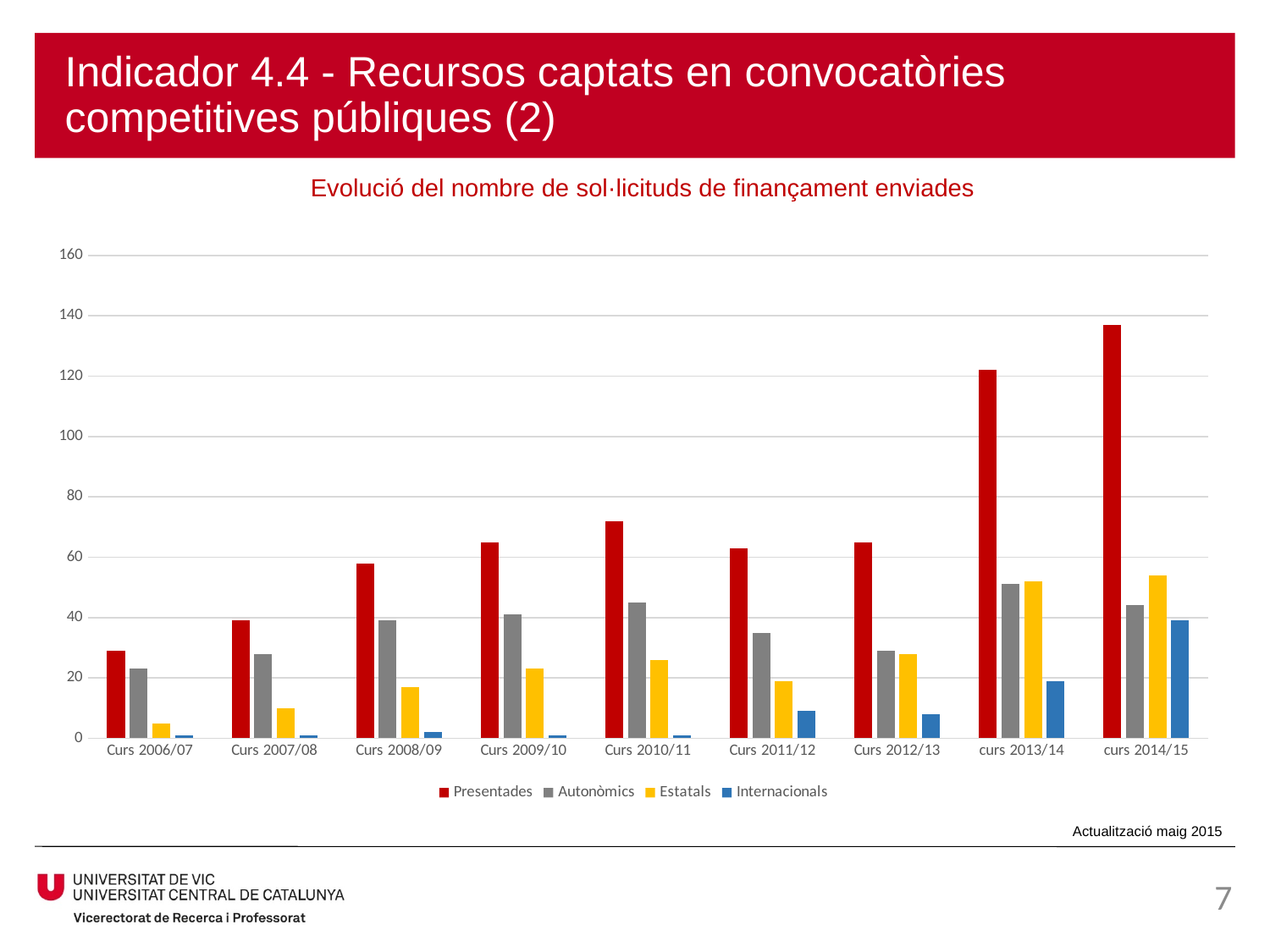
Do the Internacionals values generally rise or fall from Curs 2006/07 to curs 2014/15? rise In which academic year is the Presentades value highest? curs 2014/15 How many series does the legend list? 4 What is the title of the chart? Evolució del nombre de sol·licituds de finançament enviades Is the Presentades value for curs 2014/15 greater or less than 120? greater How many academic years (categories) are shown on the x axis? 9 Is the Presentades value for curs 2013/14 greater or less than 100? greater In curs 2014/15, which is larger: Estatals or Autonòmics? Estatals In which academic year is the Presentades value lowest? Curs 2006/07 Is the Presentades value for Curs 2006/07 greater or less than 40? less What kind of chart is shown on the slide? Bar chart